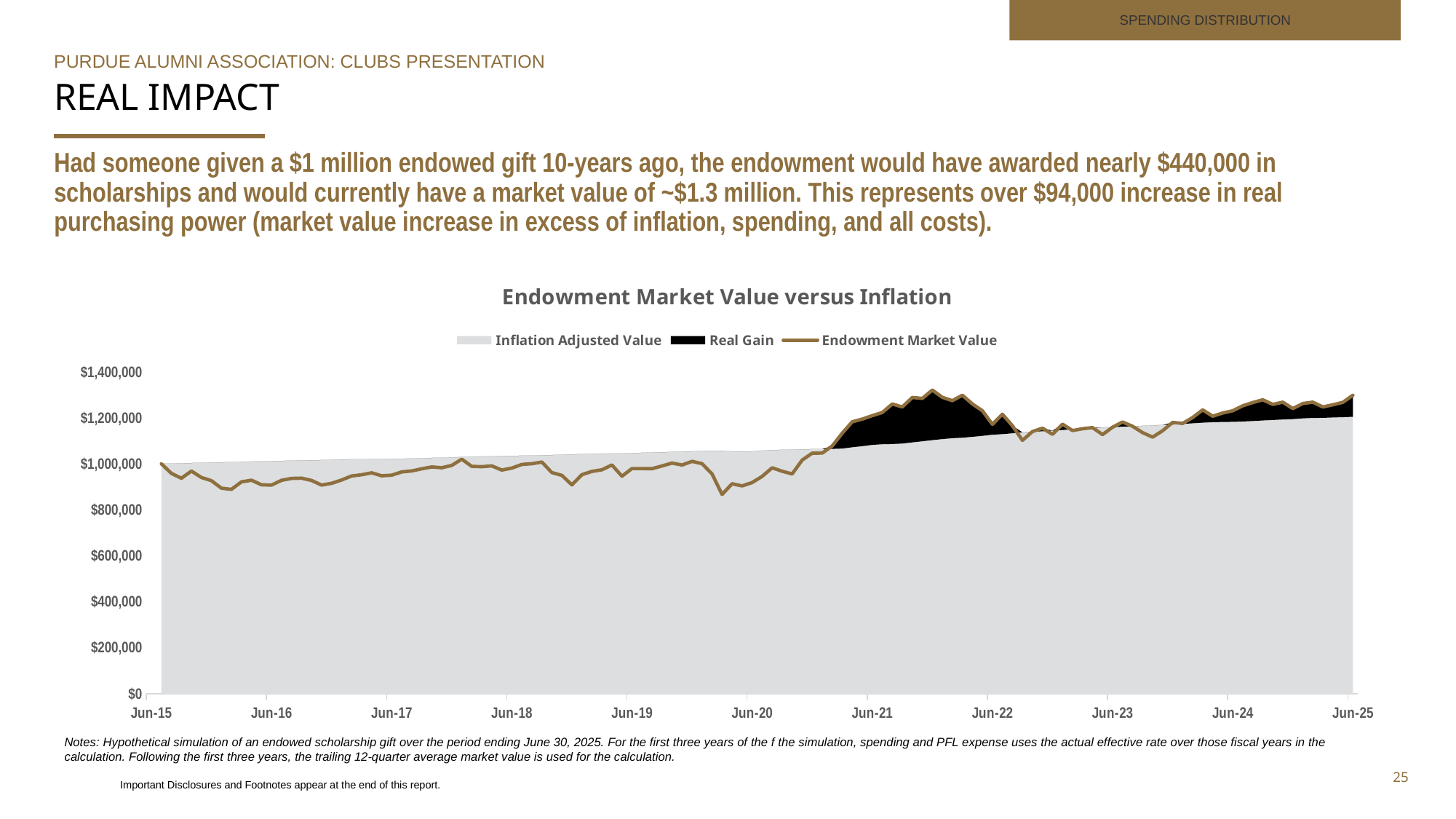
Is the Endowment Market Value at Jun-18 greater or less than $1,200,000? less Which is larger, the Endowment Market Value at Jun-20 or at Jun-24? Jun-24 Does the Inflation Adjusted Value rise or fall from Jun-15 to Jun-25? rise How many series does the chart legend list? 3 What is the title of the chart? Endowment Market Value versus Inflation What colour represents Real Gain in the chart legend? Black How many date labels are shown on the x axis of the chart? 11 Is the Endowment Market Value at Jun-25 greater or less than $1,200,000? greater Is the Endowment Market Value at Jun-20 greater or less than $1,000,000? less Which is larger, the Endowment Market Value at Jun-16 or at Jun-25? Jun-25 What kind of chart is shown on the slide? Area chart with a line